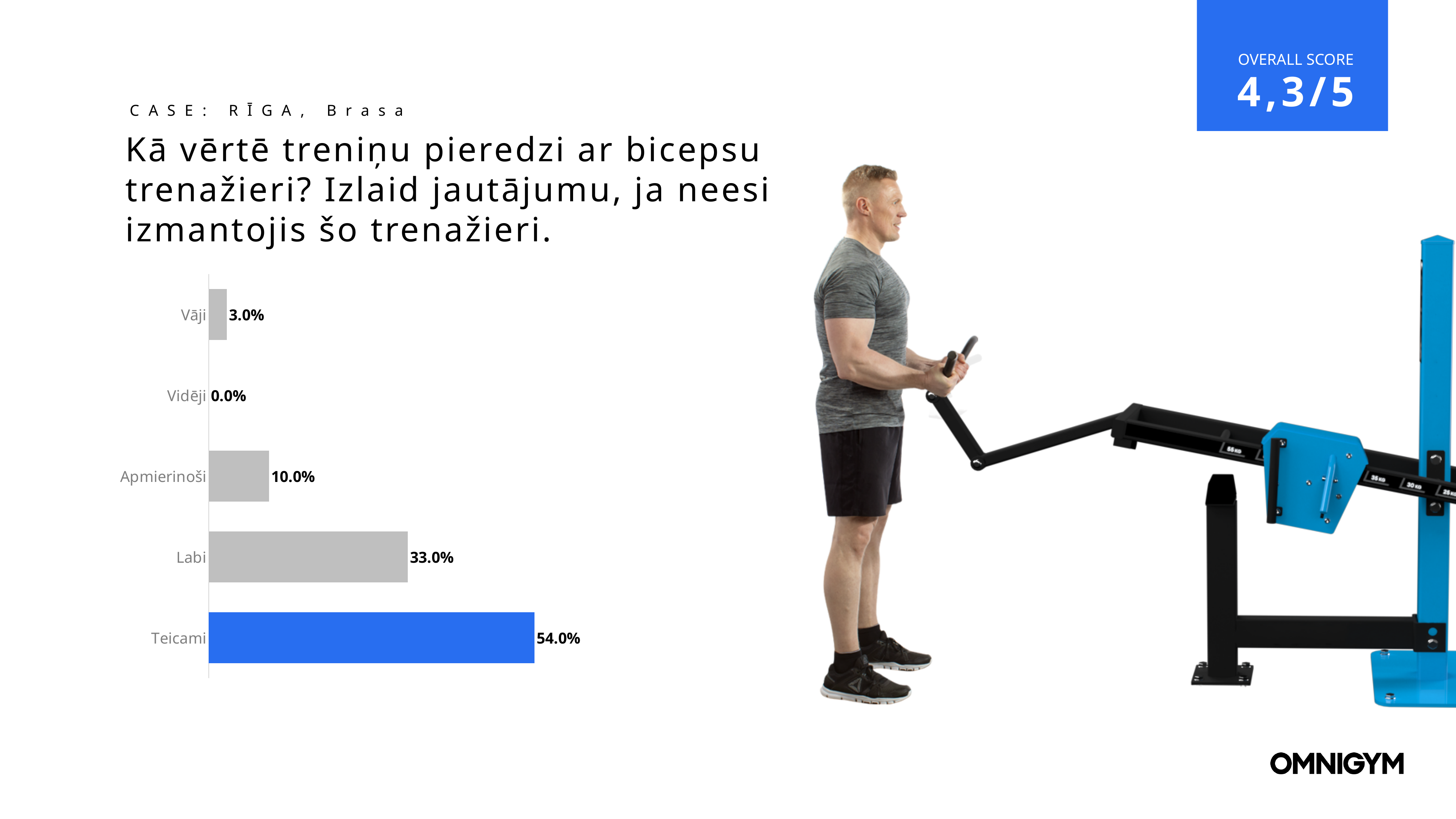
What kind of chart is shown on the slide? Bar chart Which bar is coloured blue rather than grey? Teicami How many categories are shown in the chart? 5 What is the value for Vidēji? 0.0% What is the value for Apmierinoši? 10.0% What is the difference between the values for Teicami and Labi? 21.0% Which is larger, the value for Apmierinoši or the value for Vāji? Apmierinoši What is the value for Labi? 33.0% Which category has the lowest value? Vidēji Which category has the highest value? Teicami What is the value for Teicami? 54.0% What is the value for Vāji? 3.0%